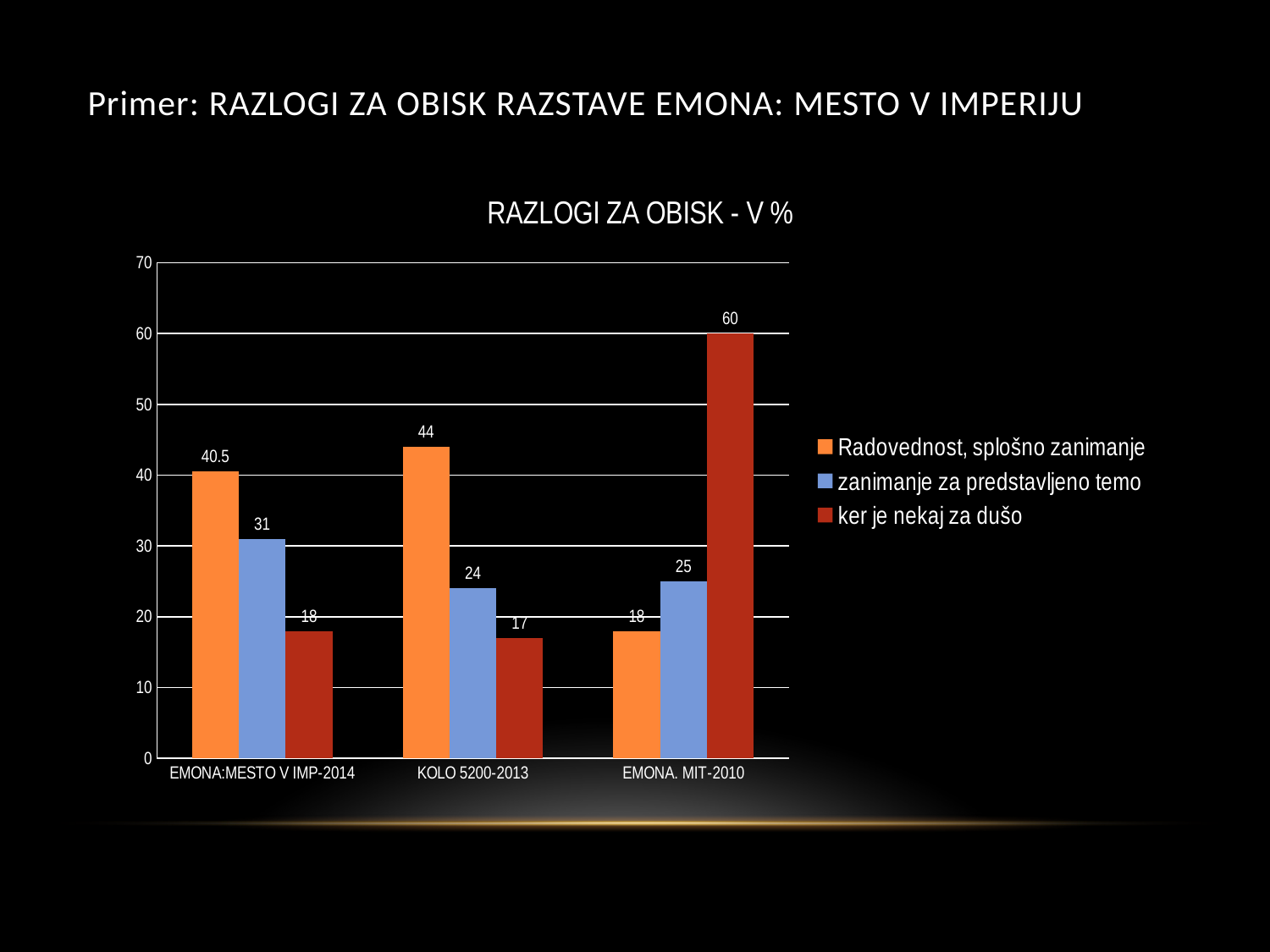
How many categories are shown on the x axis? 3 How many series does the legend list? 3 Which category has the lowest value for 'Radovednost, splošno zanimanje'? EMONA. MIT-2010 What is the title of the chart? RAZLOGI ZA OBISK - V % What is the value for 'zanimanje za predstavljeno temo' for KOLO 5200-2013? 24 Which is larger for EMONA:MESTO V IMP-2014: 'zanimanje za predstavljeno temo' or 'ker je nekaj za dušo'? zanimanje za predstavljeno temo What kind of chart is shown? bar chart Which category has the highest value for 'ker je nekaj za dušo'? EMONA. MIT-2010 What is the difference between 'Radovednost, splošno zanimanje' and 'zanimanje za predstavljeno temo' for KOLO 5200-2013? 20 Is the value for 'ker je nekaj za dušo' for EMONA. MIT-2010 greater or less than 50? greater What is the value for 'Radovednost, splošno zanimanje' for EMONA:MESTO V IMP-2014? 40.5 What is the value for 'ker je nekaj za dušo' for EMONA. MIT-2010? 60